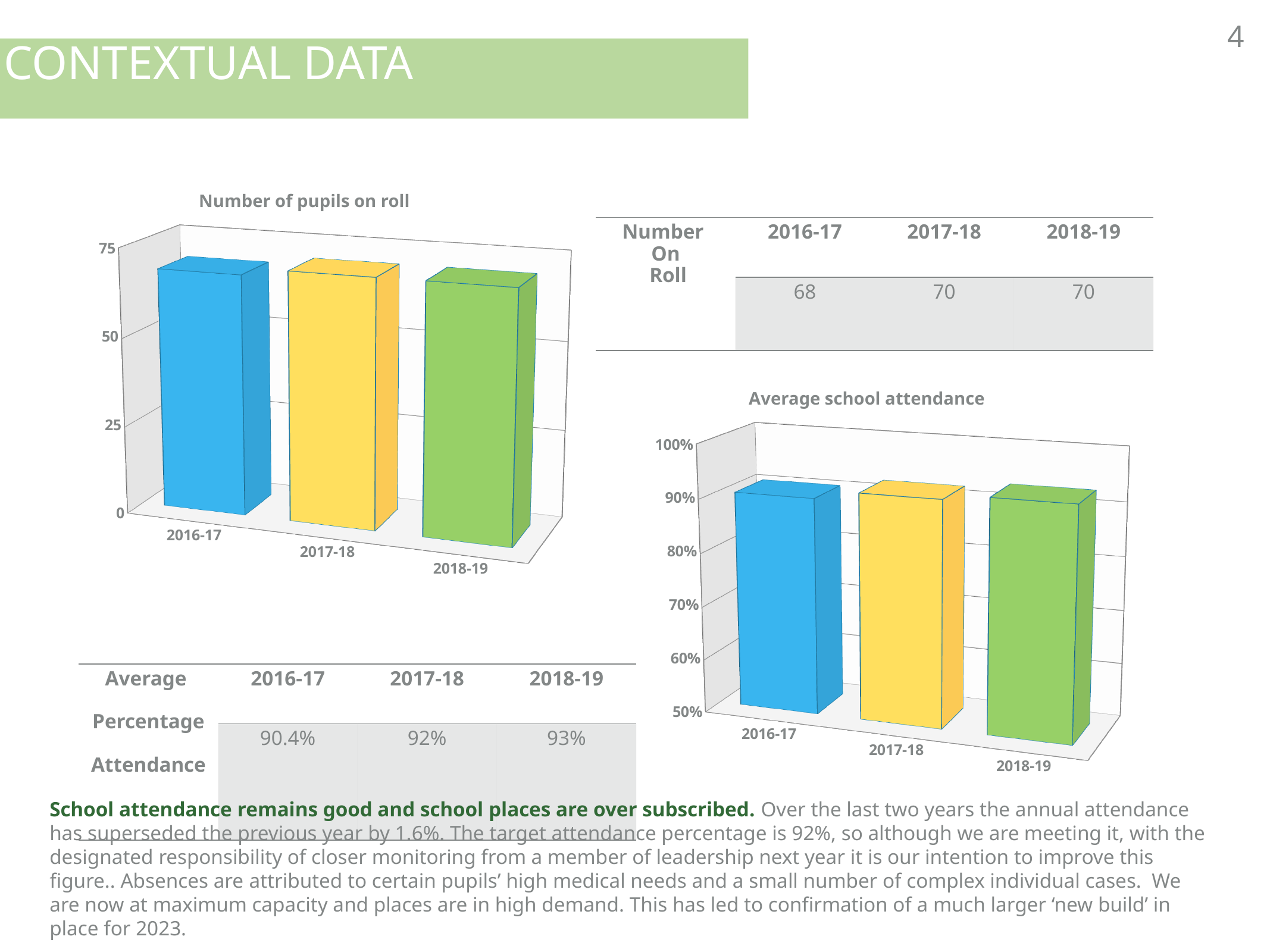
In the 'Number of pupils on roll' chart, what is the value for 2016-17? 68 In the 'Average school attendance' chart, which year has the highest attendance? 2018-19 What kind of chart is 'Number of pupils on roll'? bar chart In the 'Average school attendance' chart, what is the difference between 2018-19 and 2017-18? 1% In the 'Number of pupils on roll' chart, which year has the lowest number of pupils? 2016-17 In the 'Number of pupils on roll' chart, what is the value for 2018-19? 70 In the 'Average school attendance' chart, what is the value for 2018-19? 93% In the 'Average school attendance' chart, is the value for 2016-17 greater or less than 80%? greater In the 'Average school attendance' chart, do the values rise or fall from 2016-17 to 2018-19? rise In the 'Number of pupils on roll' chart, what is the difference between 2017-18 and 2016-17? 2 In the 'Number of pupils on roll' chart, how many years are shown? 3 In the 'Average school attendance' chart, what is the value for 2016-17? 90.4%